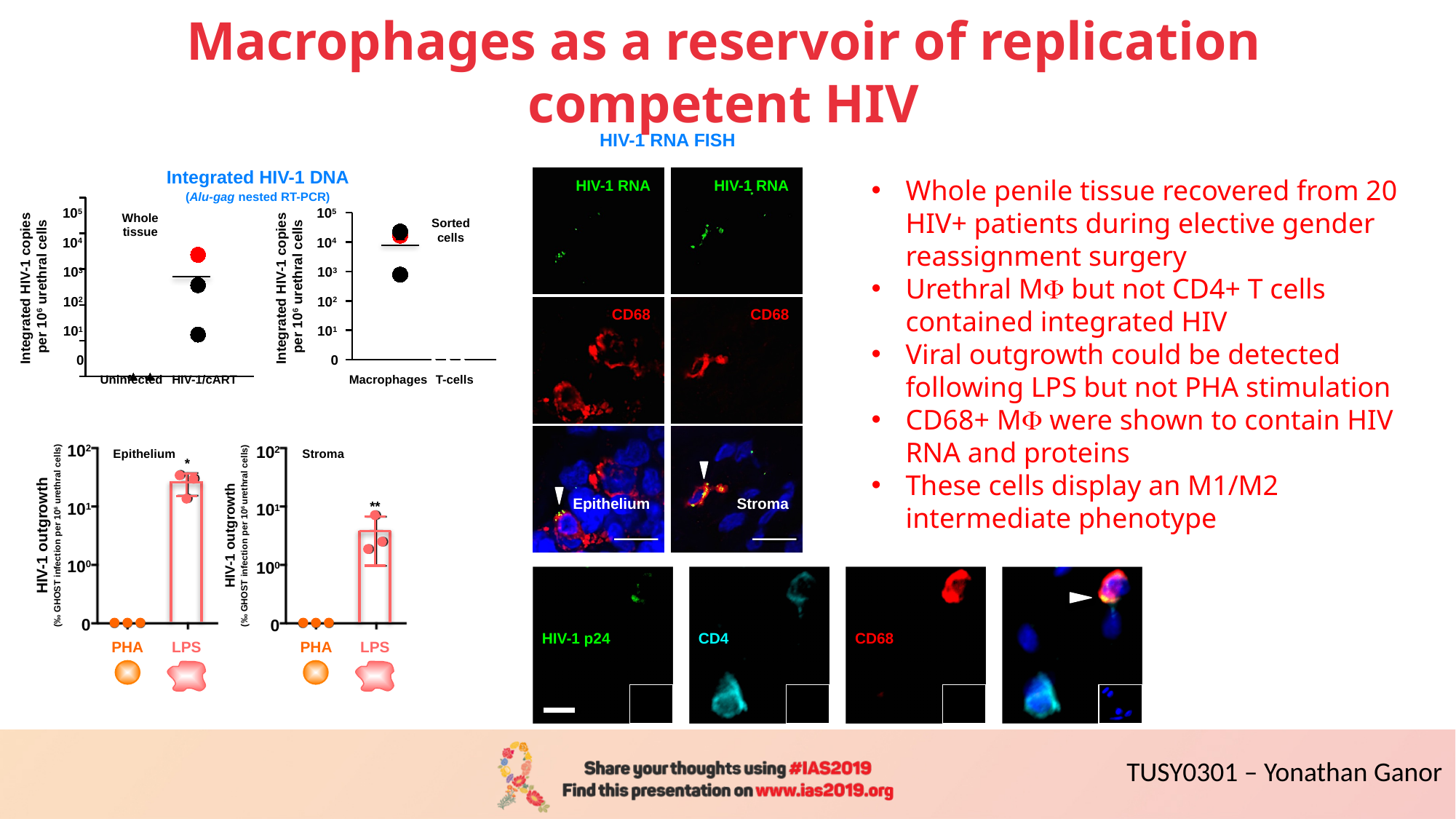
In the Sorted cells Integrated HIV-1 DNA chart, which category has the higher values, Macrophages or T-cells? Macrophages In the Epithelium HIV-1 outgrowth chart, is the value for LPS greater or less than 10^1? greater What is the title shown above the two dot plots on the left of the slide? Integrated HIV-1 DNA What is the y-axis label of the Epithelium and Stroma bar charts? HIV-1 outgrowth In the Epithelium HIV-1 outgrowth chart, how many categories are shown on the x axis? 2 In the Whole tissue Integrated HIV-1 DNA chart, how many data points are plotted for HIV-1/cART? 3 In the Epithelium HIV-1 outgrowth chart, which category has the higher value, PHA or LPS? LPS In the Whole tissue Integrated HIV-1 DNA chart, which category has the higher values, Uninfected or HIV-1/cART? HIV-1/cART In the Stroma HIV-1 outgrowth chart, is the value for LPS greater or less than 10^1? less In the Stroma HIV-1 outgrowth chart, is the value for LPS greater or less than 10^0? greater What kind of chart is the Epithelium HIV-1 outgrowth chart? bar chart In the Stroma HIV-1 outgrowth chart, what is the value for PHA? 0